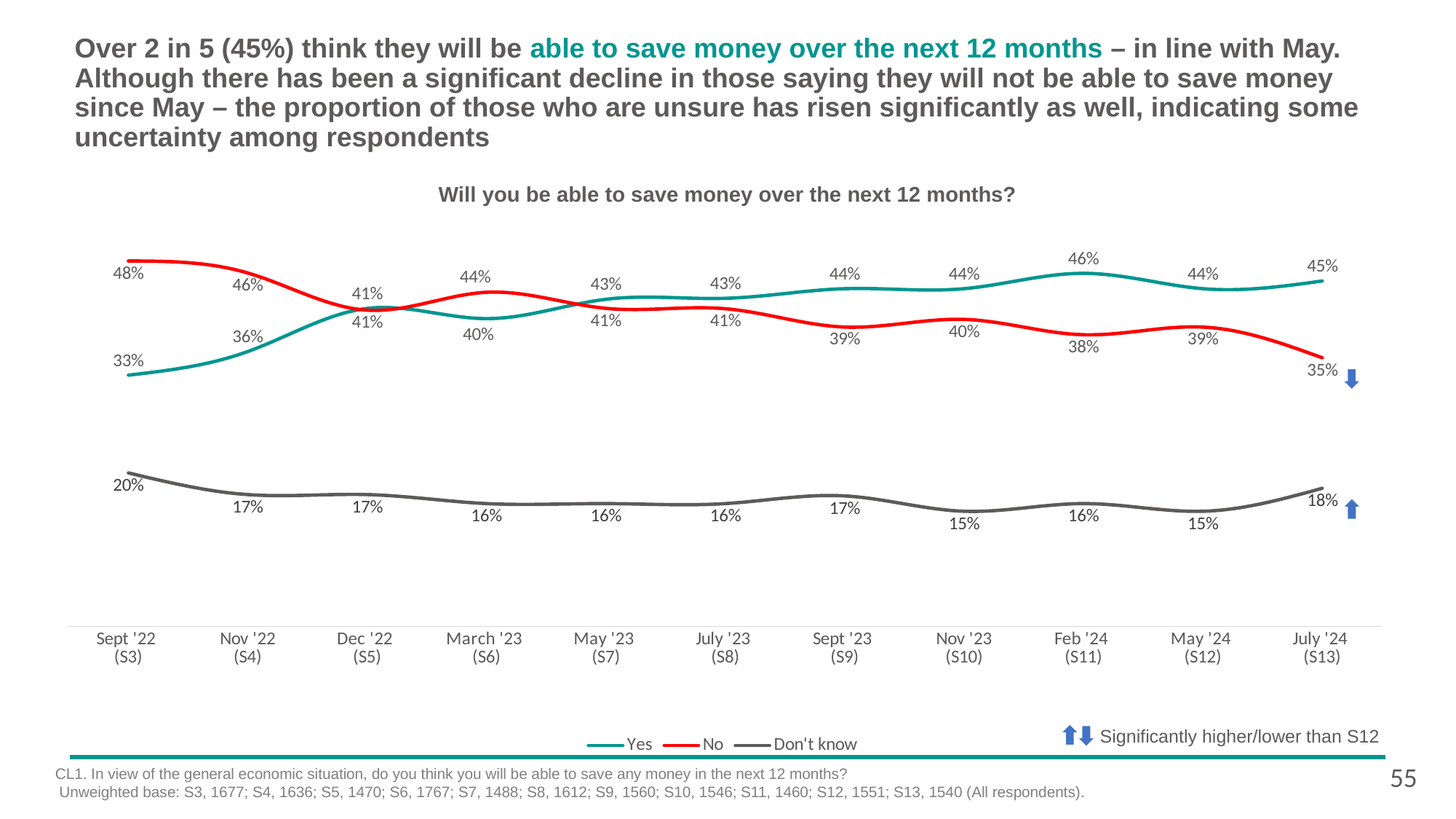
What is the value for No in Sept '22 (S3)? 48% What is the value for Don't know in Nov '23 (S10)? 15% At which time point is the Yes series highest? Feb '24 (S11) Which is larger in Sept '22 (S3): the Yes value or the No value? No Does the Yes series generally rise or fall from Sept '22 to July '24? Rise What is the value for Yes in July '24 (S13)? 45% What kind of chart is shown on the slide? Line chart How many series does the legend list? 3 At which time point is the No series lowest? July '24 (S13) How many time points are plotted along the x axis? 11 What is the difference between the No value in Sept '22 (S3) and the No value in July '24 (S13)? 13 percentage points What is the title of the chart? Will you be able to save money over the next 12 months?